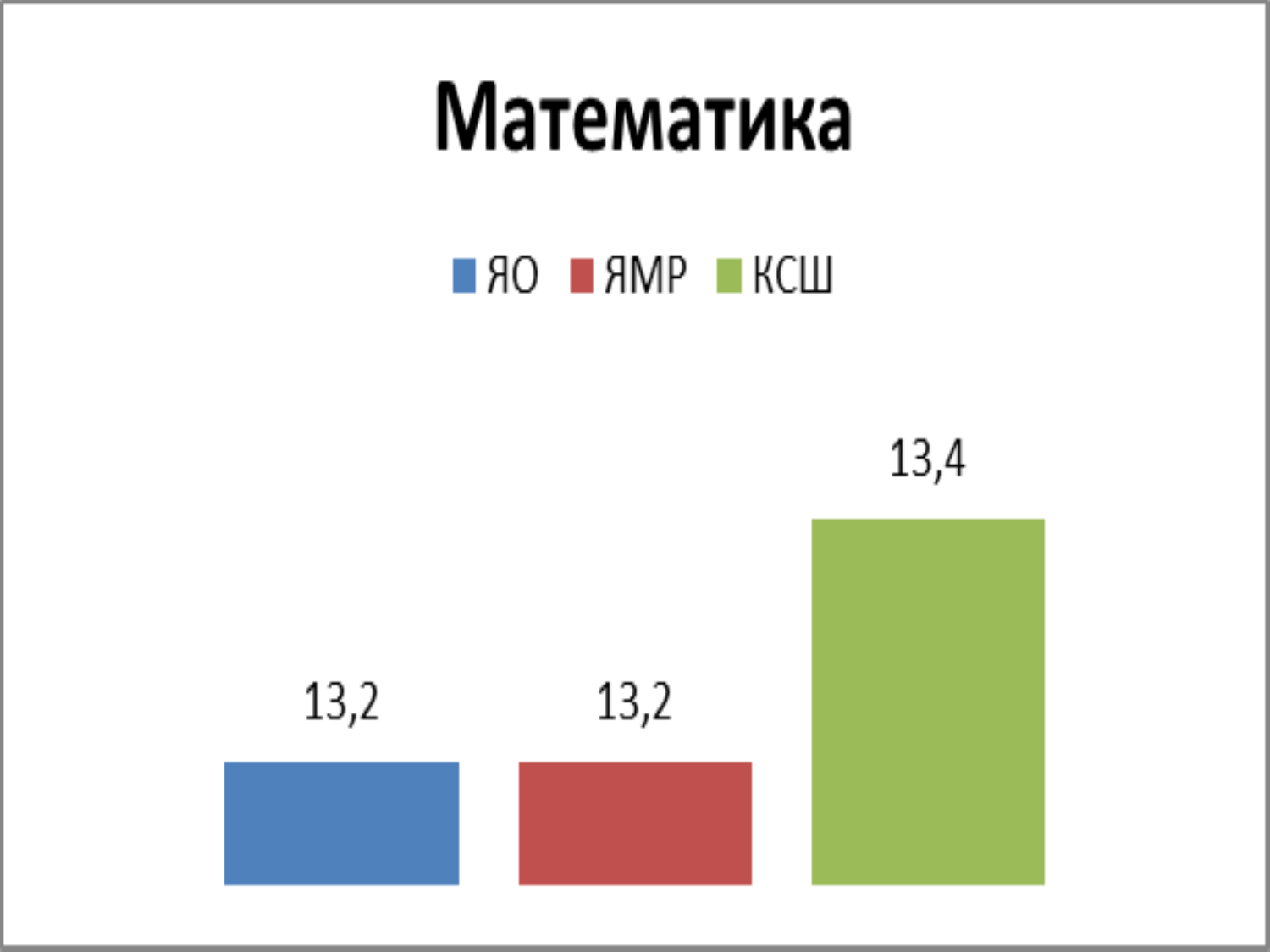
How many series does the legend list? 3 What is the value for ЯМР in the Математика chart? 13,2 Which series has the highest value in the Математика chart? КСШ Do the values for ЯО and ЯМР differ? No, both are 13,2 What kind of chart is shown on the slide? Bar chart What is the value for КСШ in the Математика chart? 13,4 How many bars are plotted in the chart? 3 What is the title of the chart? Математика Which is larger, the value for КСШ or the value for ЯМР? КСШ What is the value for ЯО in the Математика chart? 13,2 Which series is shown in green in the chart? КСШ What is the difference between the values for КСШ and ЯО? 0,2